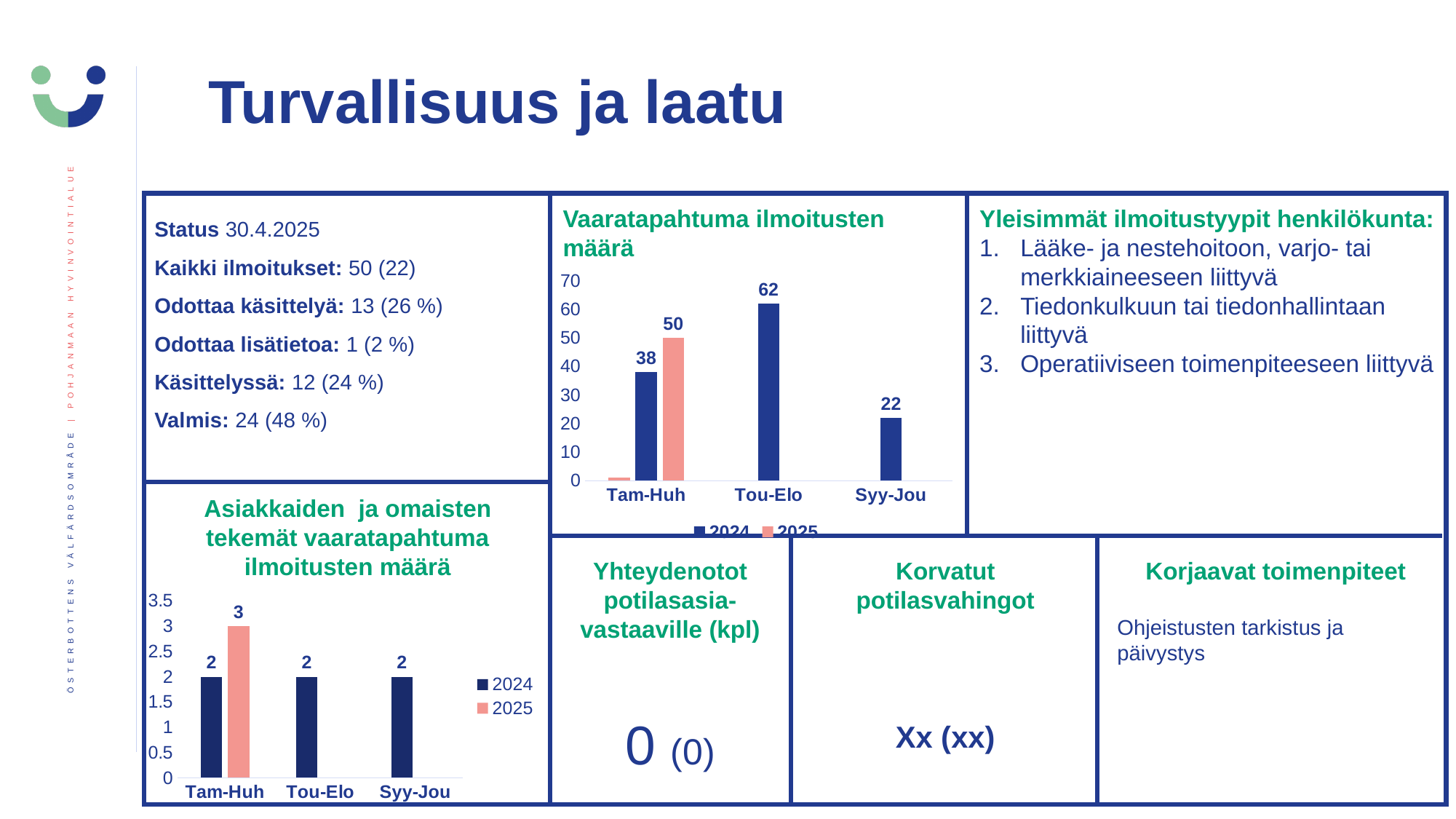
In the chart titled "Vaaratapahtuma ilmoitusten määrä", what is the 2024 value for Tou-Elo? 62 In the chart titled "Asiakkaiden ja omaisten tekemät vaaratapahtuma ilmoitusten määrä", what is the 2025 value for Tam-Huh? 3 In the chart titled "Asiakkaiden ja omaisten tekemät vaaratapahtuma ilmoitusten määrä", what is the 2024 value for Syy-Jou? 2 In the chart titled "Vaaratapahtuma ilmoitusten määrä", which period has the highest 2024 value? Tou-Elo In the chart titled "Vaaratapahtuma ilmoitusten määrä", what is the 2025 value for Tam-Huh? 50 What kind of chart is the chart titled "Asiakkaiden ja omaisten tekemät vaaratapahtuma ilmoitusten määrä"? bar chart In the chart titled "Vaaratapahtuma ilmoitusten määrä", what is the 2024 value for Syy-Jou? 22 In the chart titled "Asiakkaiden ja omaisten tekemät vaaratapahtuma ilmoitusten määrä", how many series does the legend list? 2 In the chart titled "Vaaratapahtuma ilmoitusten määrä", how many periods are shown on the x axis? 3 In the chart titled "Vaaratapahtuma ilmoitusten määrä", which period has the lowest 2024 value? Syy-Jou In the chart titled "Vaaratapahtuma ilmoitusten määrä", which is larger for Tam-Huh: the 2024 value or the 2025 value? 2025 In the chart titled "Vaaratapahtuma ilmoitusten määrä", what is the difference between the 2024 values for Tou-Elo and Tam-Huh? 24